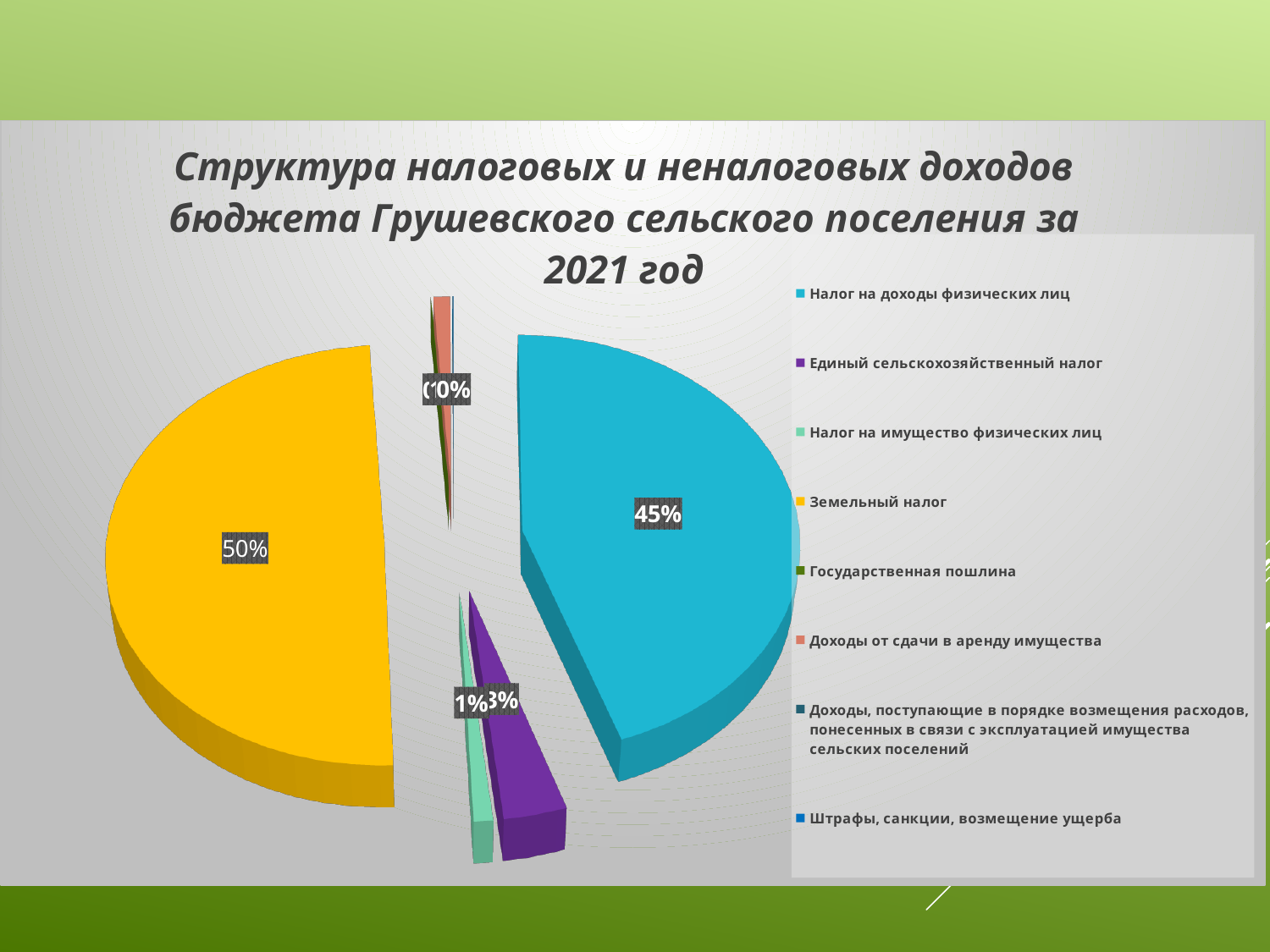
Which category has the largest slice of the pie? Земельный налог By how many percentage points does the Единый сельскохозяйственный налог slice exceed the Налог на имущество физических лиц slice? 2 percentage points What kind of chart is shown on the slide? Pie chart What share of the pie does Налог на имущество физических лиц account for? 1% What share of the pie does Налог на доходы физических лиц account for? 45% What year does the chart title say the data is for? 2021 Which is larger: the slice for Земельный налог or the slice for Налог на доходы физических лиц? Земельный налог What share of the pie does Единый сельскохозяйственный налог account for? 3% What colour is the slice for Земельный налог? Yellow How many categories does the legend list? 8 What share of the pie does Земельный налог account for? 50% By how many percentage points does the Земельный налог slice exceed the Налог на доходы физических лиц slice? 5 percentage points